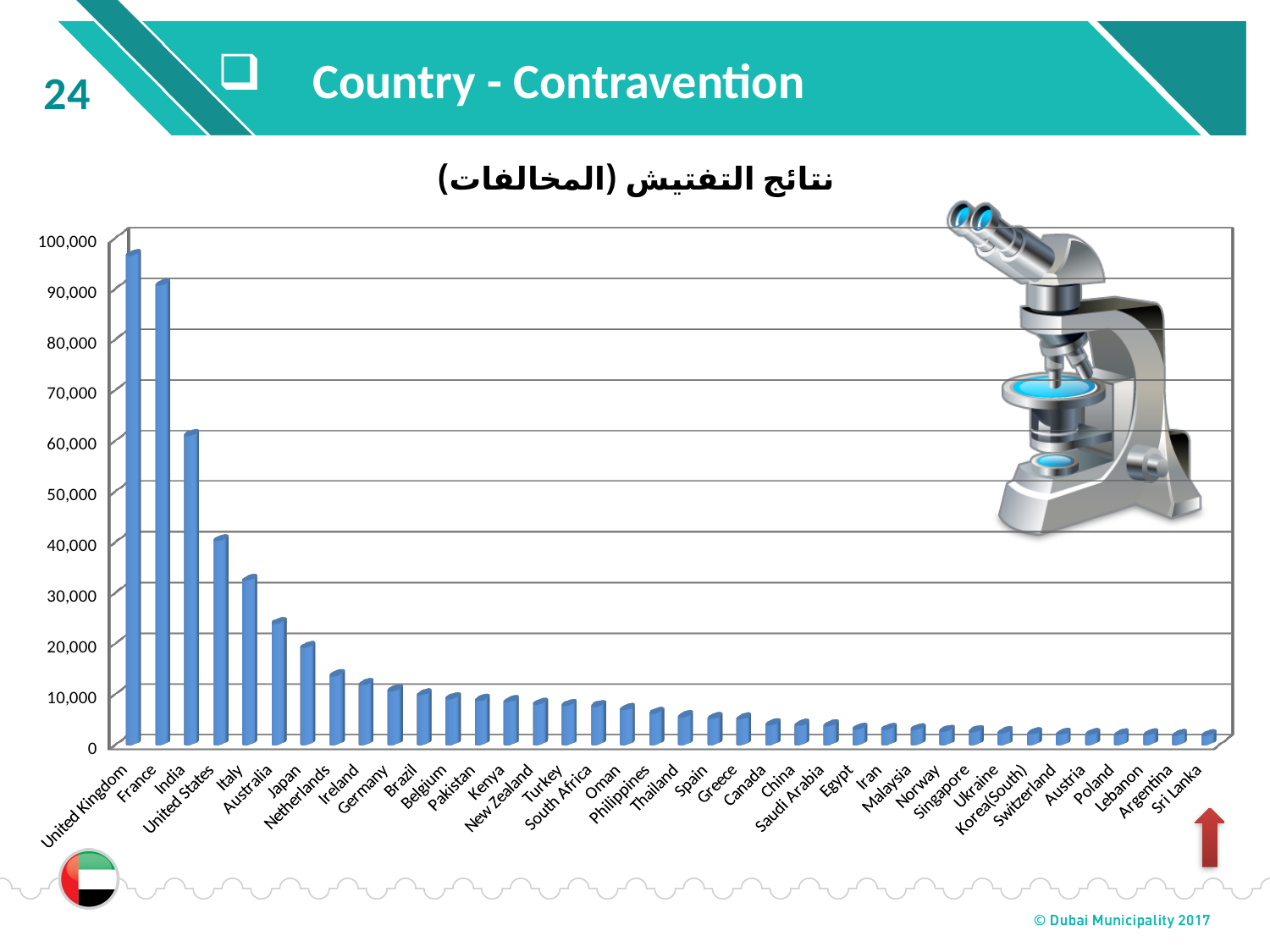
Is the value for India greater or less than 70,000? less How many countries are shown on the x axis of the chart? 38 What kind of chart is shown on the slide? bar chart Is the value for Australia greater or less than 20,000? greater Which has a larger value, Italy or Japan? Italy Do the values rise or fall moving from left to right along the x axis? fall Is the value for Netherlands greater or less than 10,000? greater Which country has the highest value in the chart? United Kingdom Which has a larger value, France or India? France